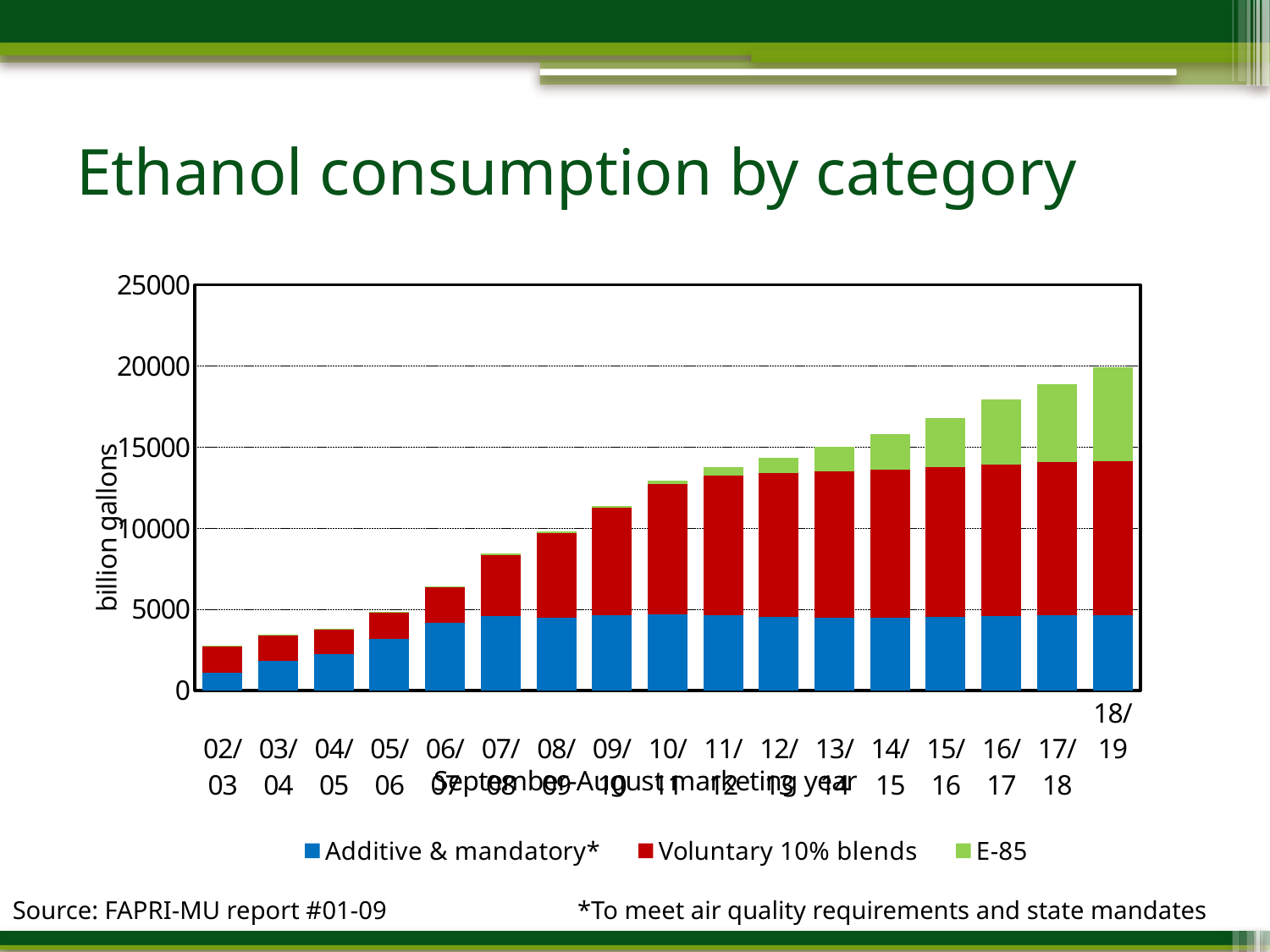
Is the total value for 02/03 greater or less than 5000? less How many series does the legend list? 3 What kind of chart is shown on the slide? bar chart What is the label on the y axis? billion gallons Is the total value for 18/19 greater or less than 15000? greater Is the total value for 10/11 greater or less than 10000? greater How many marketing years are shown on the x axis? 17 Which marketing year has the lowest total ethanol consumption? 02/03 Do total ethanol consumption values rise or fall from 02/03 to 18/19? rise Which marketing year has the highest total ethanol consumption? 18/19 Which has the larger total ethanol consumption, 05/06 or 06/07? 06/07